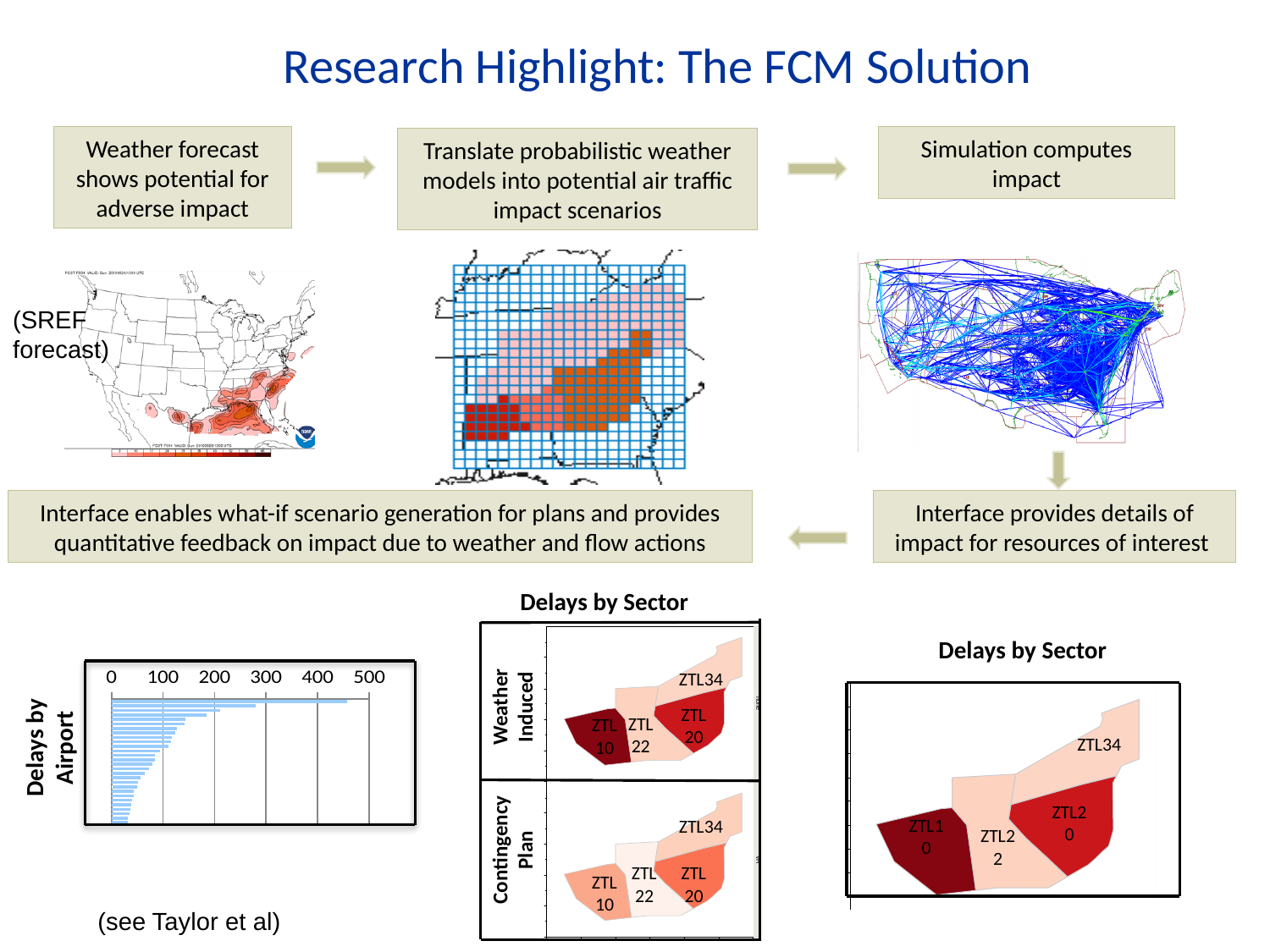
In the "Delays by Airport" chart, is the value of the shortest bar greater or less than 100? less What is the title of the bar chart in the lower left of the slide? Delays by Airport In the "Delays by Airport" chart, do the bar lengths increase or decrease going from the top bar to the bottom bar? decrease In the "Delays by Airport" chart, is the value of the second-longest bar greater or less than 300? less What kind of chart is the "Delays by Airport" chart? bar chart In the "Delays by Airport" chart, is the value of the longest bar greater or less than 500? less In the "Delays by Airport" chart, which bar is longer, the top bar or the bottom bar? the top bar What is the highest tick value shown on the axis of the "Delays by Airport" chart? 500